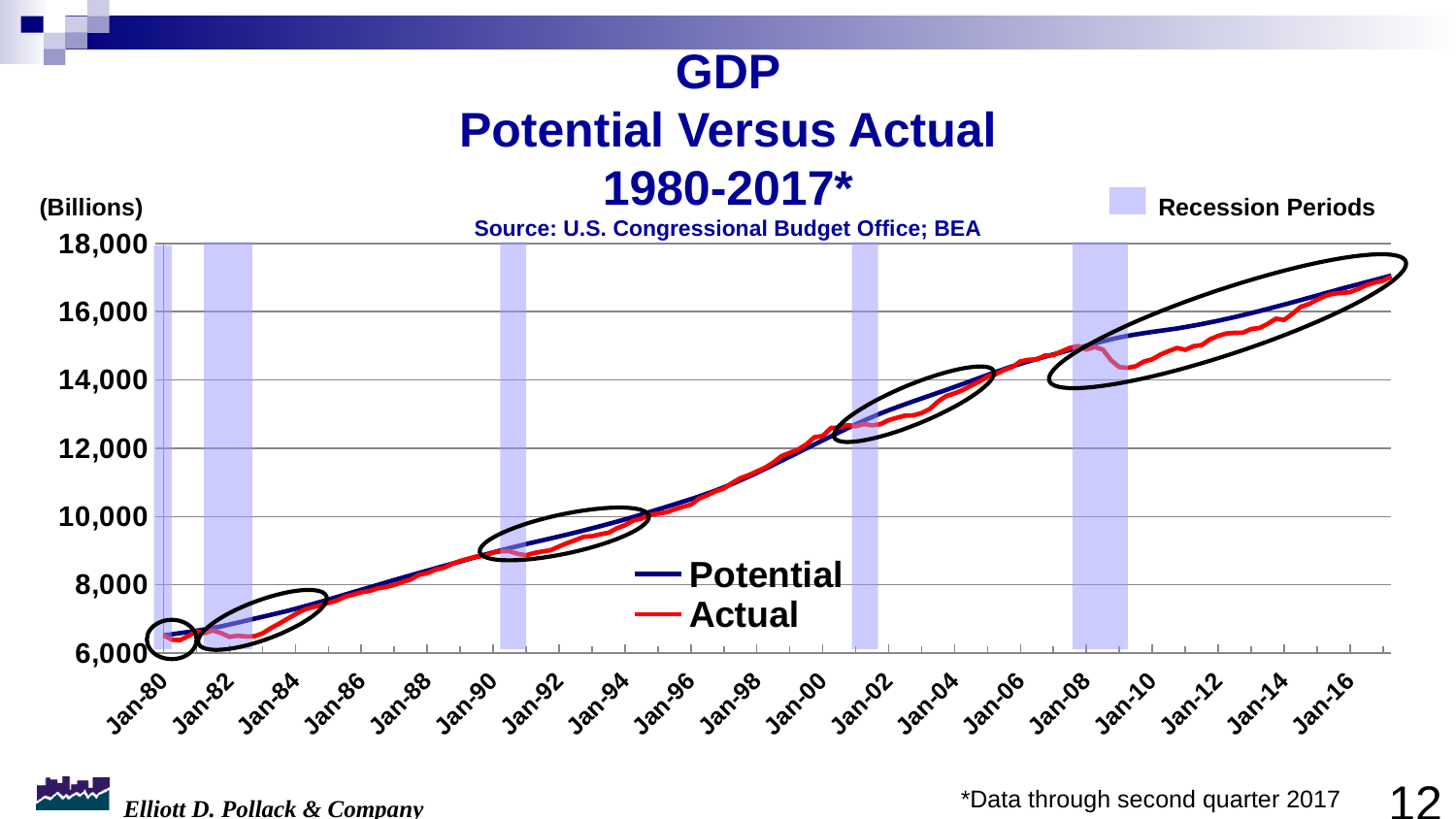
What is the title of the chart? GDP Potential Versus Actual 1980-2017* Around Jan-10, which series is higher, Potential or Actual? Potential Around Jan-12, which series is higher, Potential or Actual? Potential How many series does the legend list? 2 Is the Potential value at Jan-16 greater or less than 16,000? greater Is the Actual value at Jan-10 greater or less than 16,000? less Is the Actual value at Jan-06 greater or less than 14,000? greater How many date labels are shown along the x axis? 19 What are the names of the two series plotted on the chart? Potential and Actual What kind of chart is shown on the slide? Line chart Do the GDP values generally rise or fall from Jan-80 to Jan-16? Rise